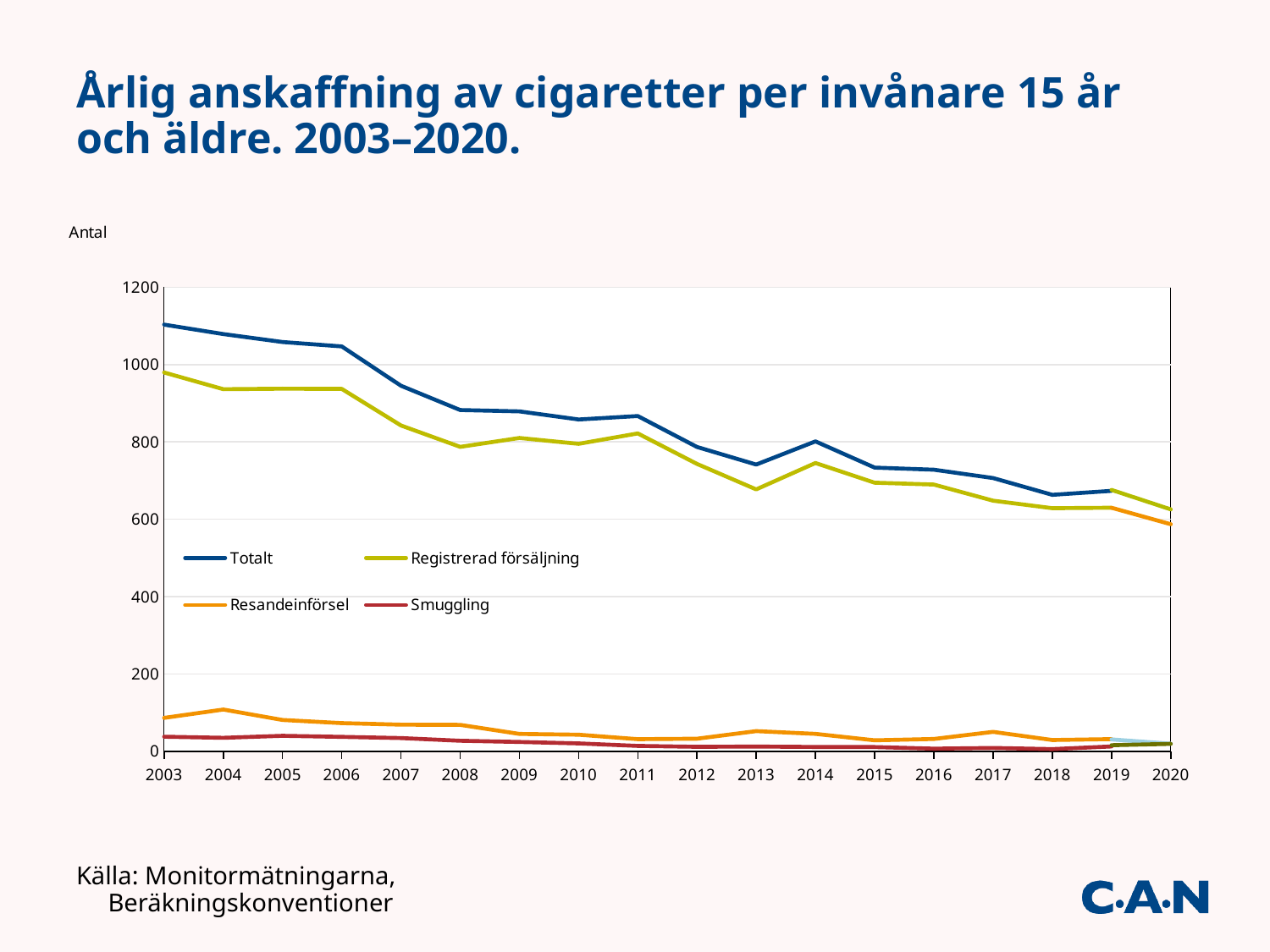
In which year is the Totalt series at its highest? 2003 In which year is the Totalt series at its lowest? 2020 Is the value for Resandeinförsel in 2004 greater or less than 200? less Is the value for Totalt in 2003 greater or less than 1000? greater Is the value for Totalt in 2020 greater or less than 800? less What label is shown on the vertical axis of the chart? Antal In 2004, which is larger: Resandeinförsel or Smuggling? Resandeinförsel What kind of chart is shown on the slide? line chart How many series does the legend list? 4 How many years are plotted along the x axis? 18 Does the Totalt series rise or fall from 2003 to 2020? fall